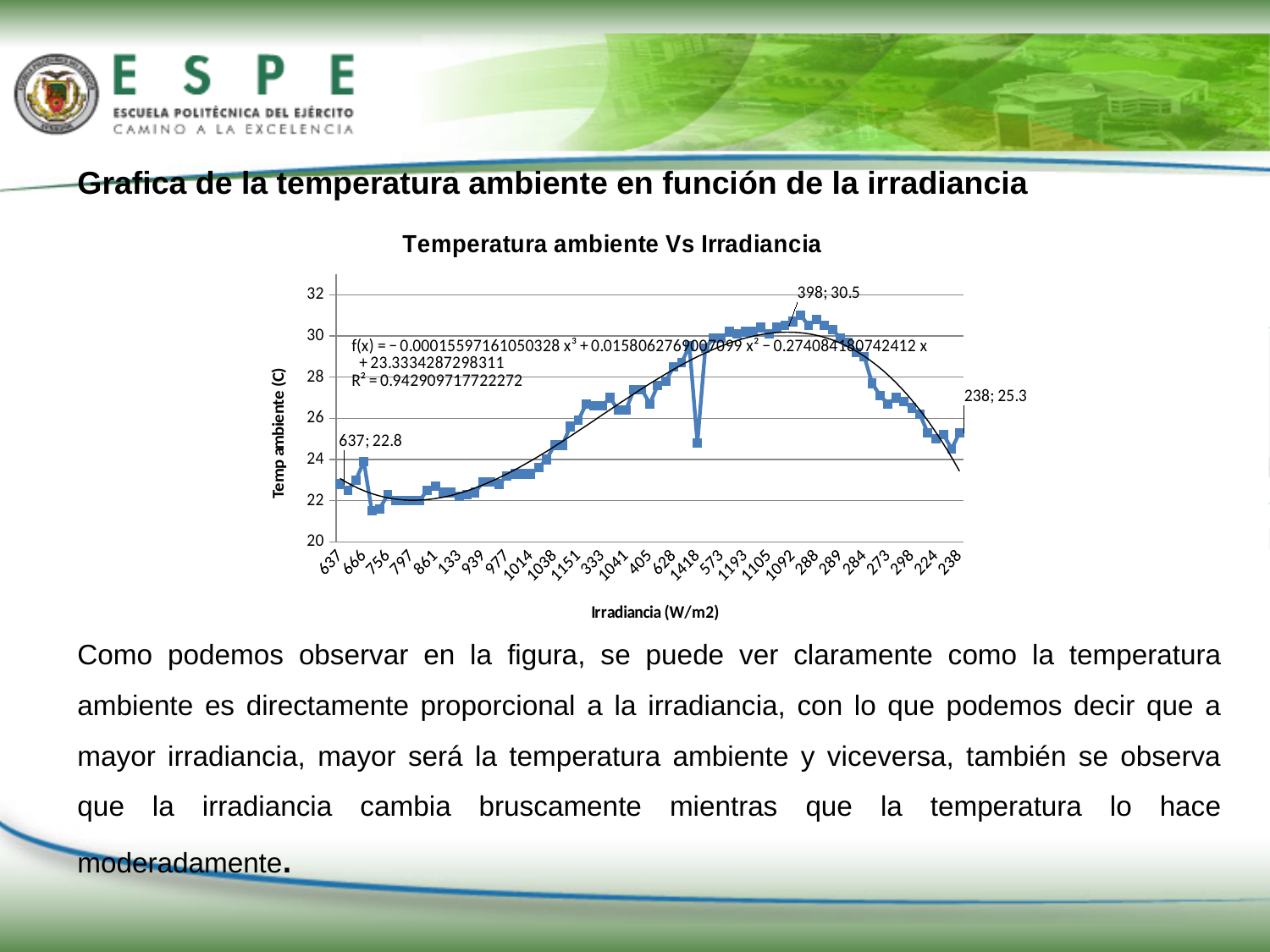
What kind of chart is shown on the slide? line chart Is the temperature value at irradiance 1092 greater or less than 28? greater What is the R² value shown for the trendline on the chart? 0.942909717722272 What is the temperature value labelled at irradiance 238 on the chart? 25.3 What is the difference between the labelled temperatures at irradiance 398 and irradiance 637? 7.7 Does the temperature rise or fall along the x axis from irradiance 637 to irradiance 398? rise Which labelled point has the higher temperature: irradiance 637 or irradiance 238? 238 Of the three labelled points on the chart, which irradiance value has the highest temperature? 398 What is the temperature value labelled at irradiance 637 on the chart? 22.8 What is the difference between the labelled temperatures at irradiance 398 and irradiance 238? 5.2 Is the temperature value at irradiance 797 greater or less than 24? less What is the temperature value labelled at irradiance 398 on the chart? 30.5